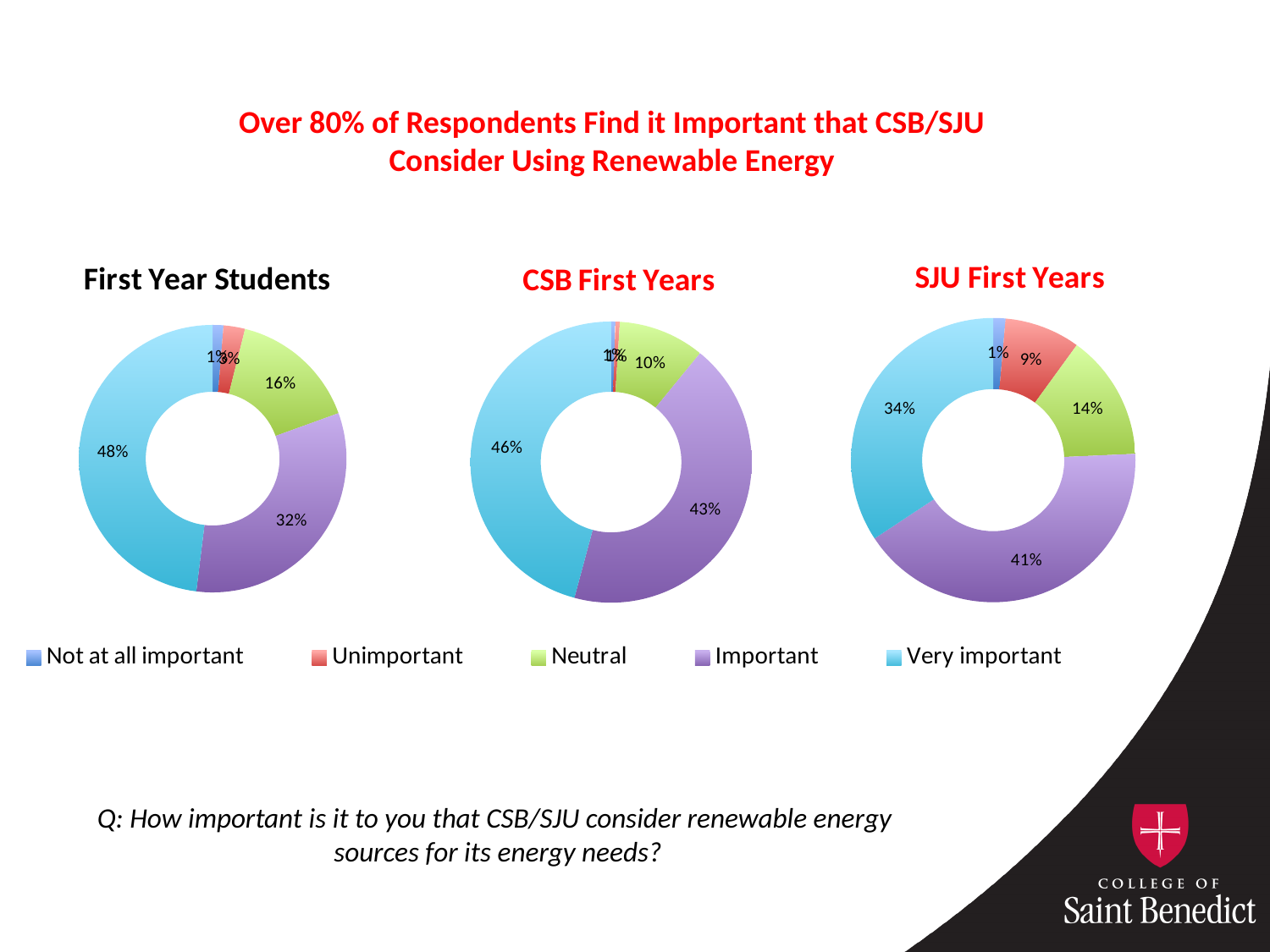
In the "SJU First Years" chart, which response category has the largest share? Important In the "CSB First Years" chart, what percentage of respondents said "Important"? 43% In the "CSB First Years" chart, what percentage of respondents said "Very important"? 46% In the "First Year Students" chart, which response category has the largest share? Very important In the "First Year Students" chart, what percentage of respondents said "Very important"? 48% In the "CSB First Years" chart, which is larger, the "Neutral" share or the "Important" share? Important What type of chart is used for "SJU First Years"? Doughnut chart In the "SJU First Years" chart, what percentage of respondents said "Unimportant"? 9% In the "First Year Students" chart, what percentage of respondents said "Important"? 32% In the "SJU First Years" chart, what is the difference between the "Important" and "Very important" shares? 7% How many response categories does the legend list? 5 In the "First Year Students" chart, what percentage of respondents said "Neutral"? 16%